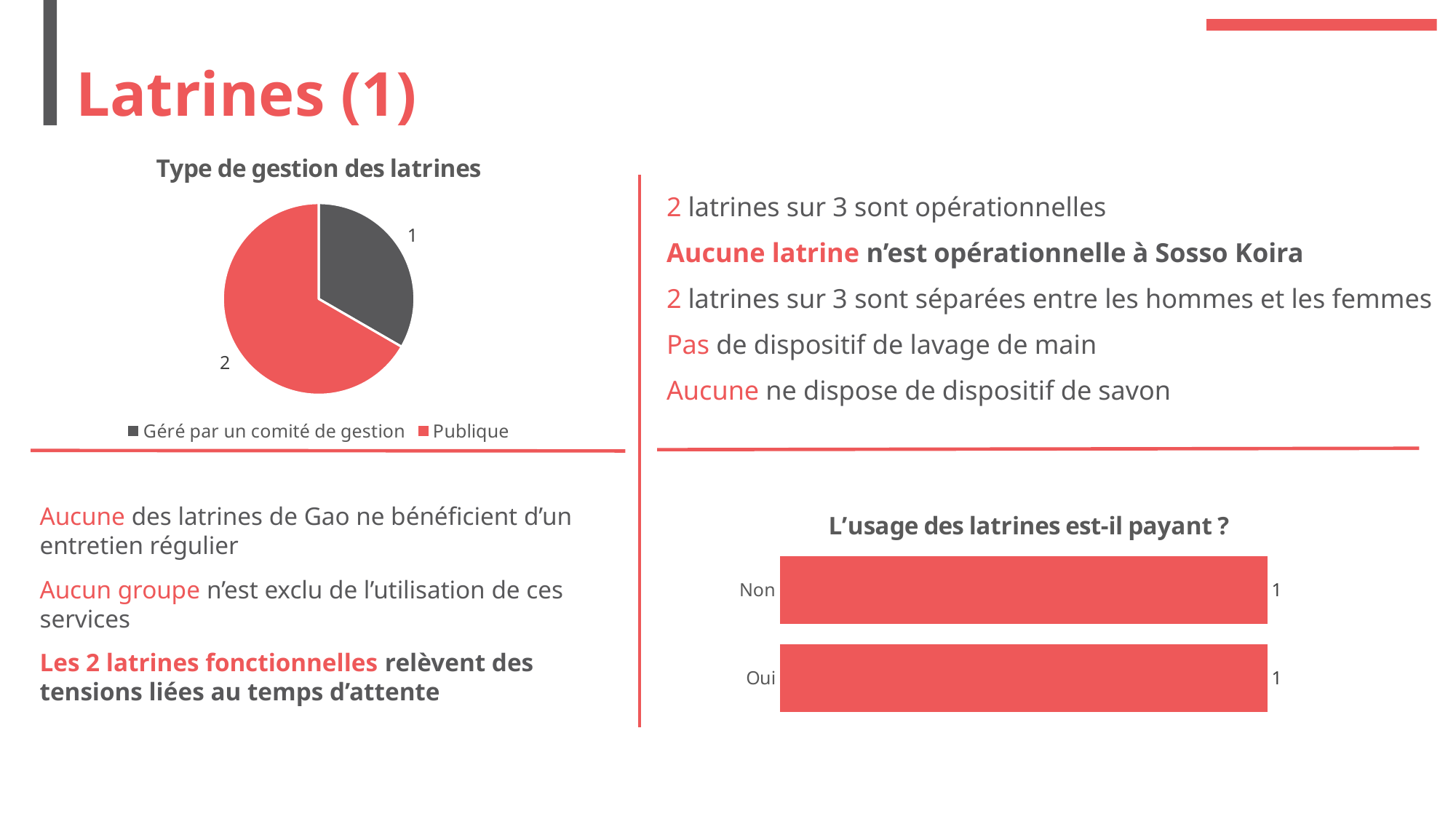
In the chart 'L'usage des latrines est-il payant ?', what is the value for 'Non'? 1 What kind of chart is 'L'usage des latrines est-il payant ?'? Bar chart In the chart 'L'usage des latrines est-il payant ?', what is the value for 'Oui'? 1 In the chart 'L'usage des latrines est-il payant ?', how many categories are shown? 2 In the chart 'Type de gestion des latrines', what is the value for 'Géré par un comité de gestion'? 1 In the chart 'Type de gestion des latrines', which colour represents 'Publique'? Red In the chart 'Type de gestion des latrines', which category has the largest slice? Publique In the chart 'Type de gestion des latrines', which category has the smallest slice? Géré par un comité de gestion In the chart 'Type de gestion des latrines', what is the difference between the values for 'Publique' and 'Géré par un comité de gestion'? 1 What kind of chart is 'Type de gestion des latrines'? Pie chart In the chart 'Type de gestion des latrines', what is the value for 'Publique'? 2 In the chart 'Type de gestion des latrines', how many categories does the legend list? 2